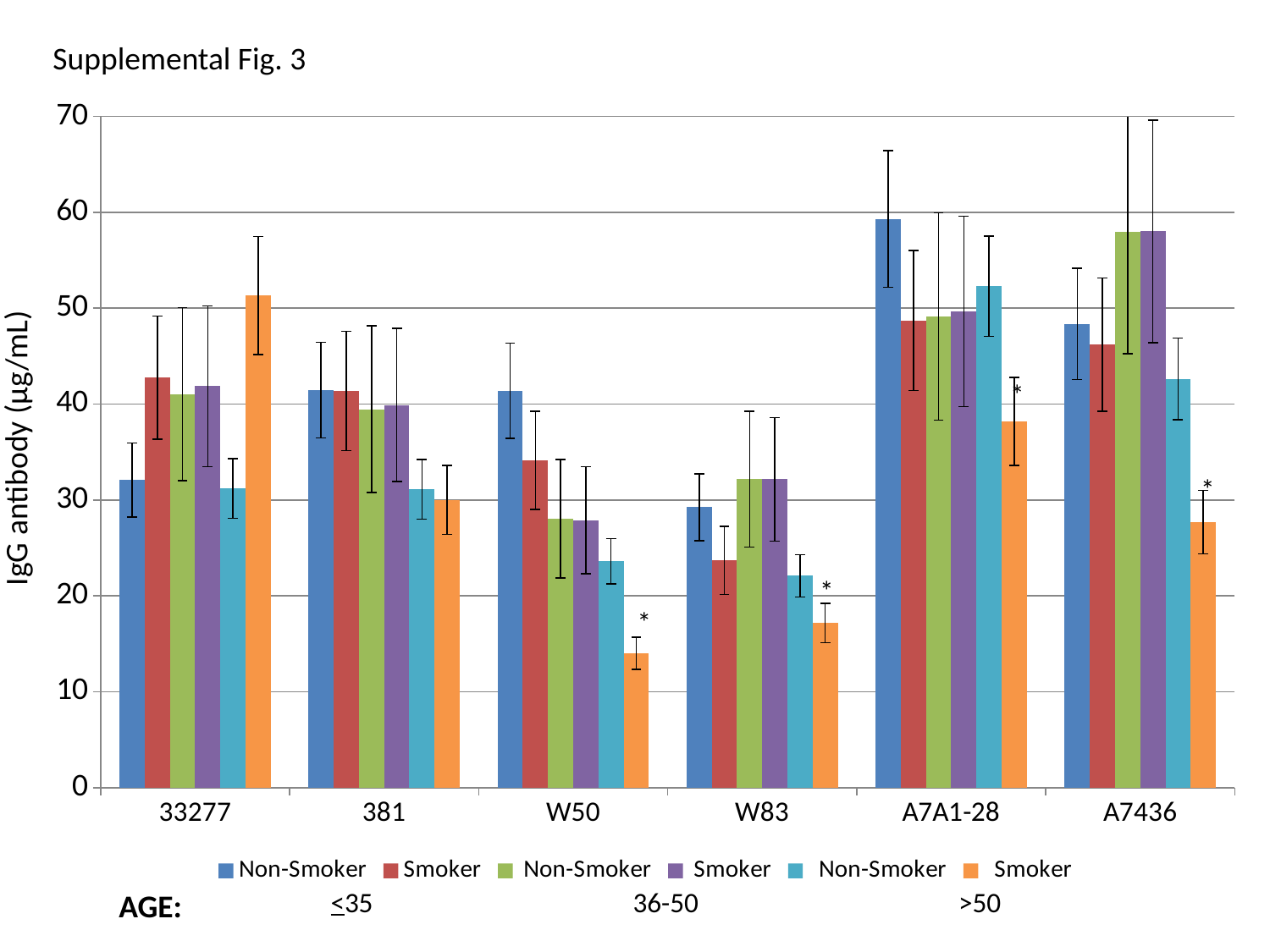
What is the label of the y axis? IgG antibody (µg/mL) For the Smoker series in the >50 age group, which is larger: the value for A7A1-28 or the value for A7436? A7A1-28 Is the value for the Smoker series in the >50 age group for W50 greater or less than 20? less Is the value for the Non-Smoker series in the ≤35 age group for A7A1-28 greater or less than 50? greater How many series does the legend list? 6 Is the value for the Non-Smoker series in the >50 age group for W50 greater or less than 30? less How many categories are shown along the x axis? 6 What kind of chart is shown on the slide? bar chart For category W83, which series has the lowest bar? Smoker (>50) For category 33277, which series has the highest bar? Smoker (>50) For the Non-Smoker series in the ≤35 age group, which is larger: the value for 33277 or the value for 381? 381